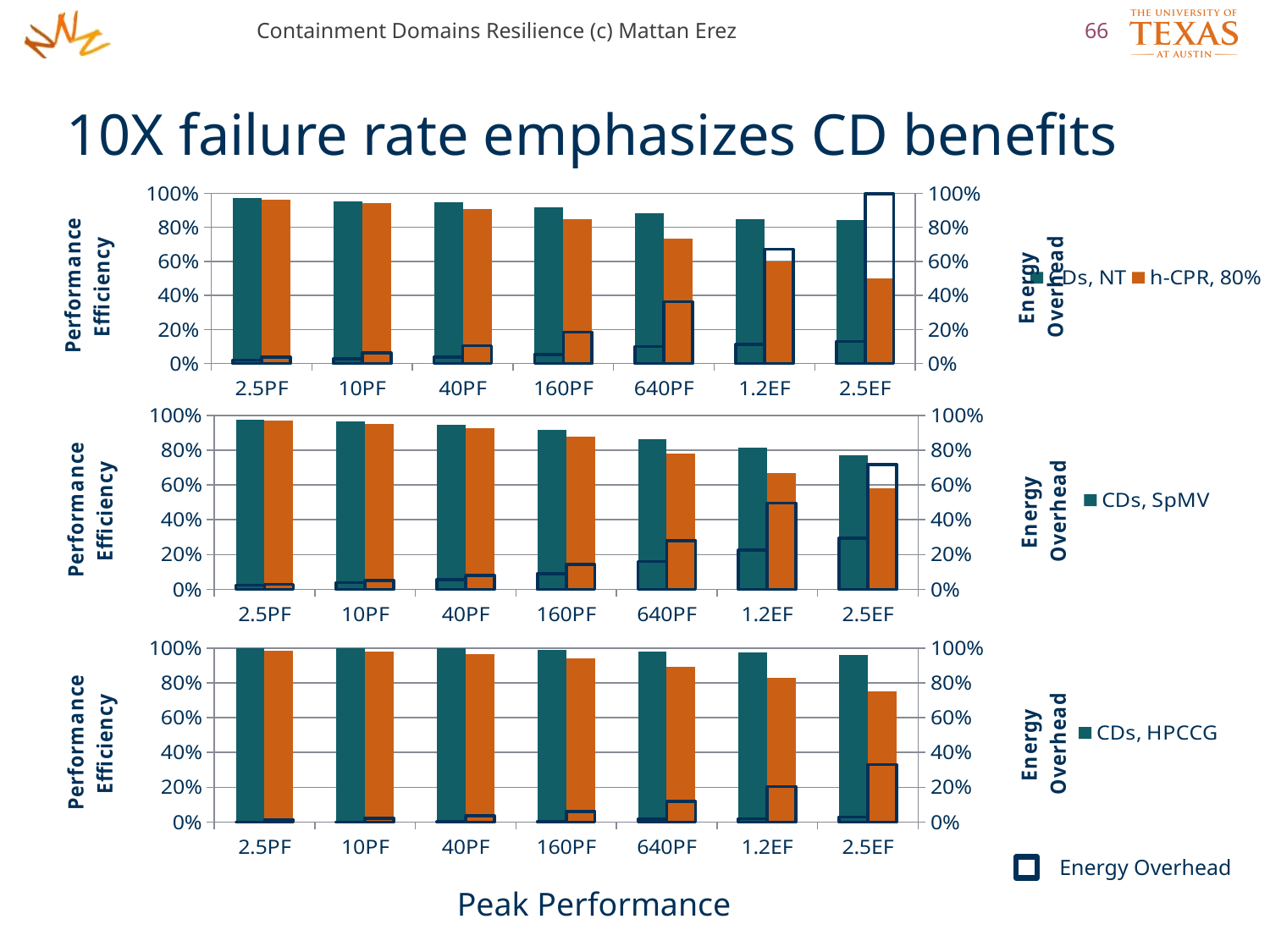
In the top chart, is the performance efficiency of h-CPR, 80% at 640PF greater or less than 60%? greater How many peak performance categories are shown on the x axis of the bottom chart? 7 In the top chart, which series has the larger performance efficiency at 2.5EF, CDs, NT or h-CPR, 80%? CDs, NT What kind of chart is the top chart on the slide? bar chart Which series does the legend of the middle chart name? CDs, SpMV What is the x-axis title shared by the charts on the slide? Peak Performance In the top chart, is the energy overhead of h-CPR, 80% at 2.5EF greater or less than 80%? greater